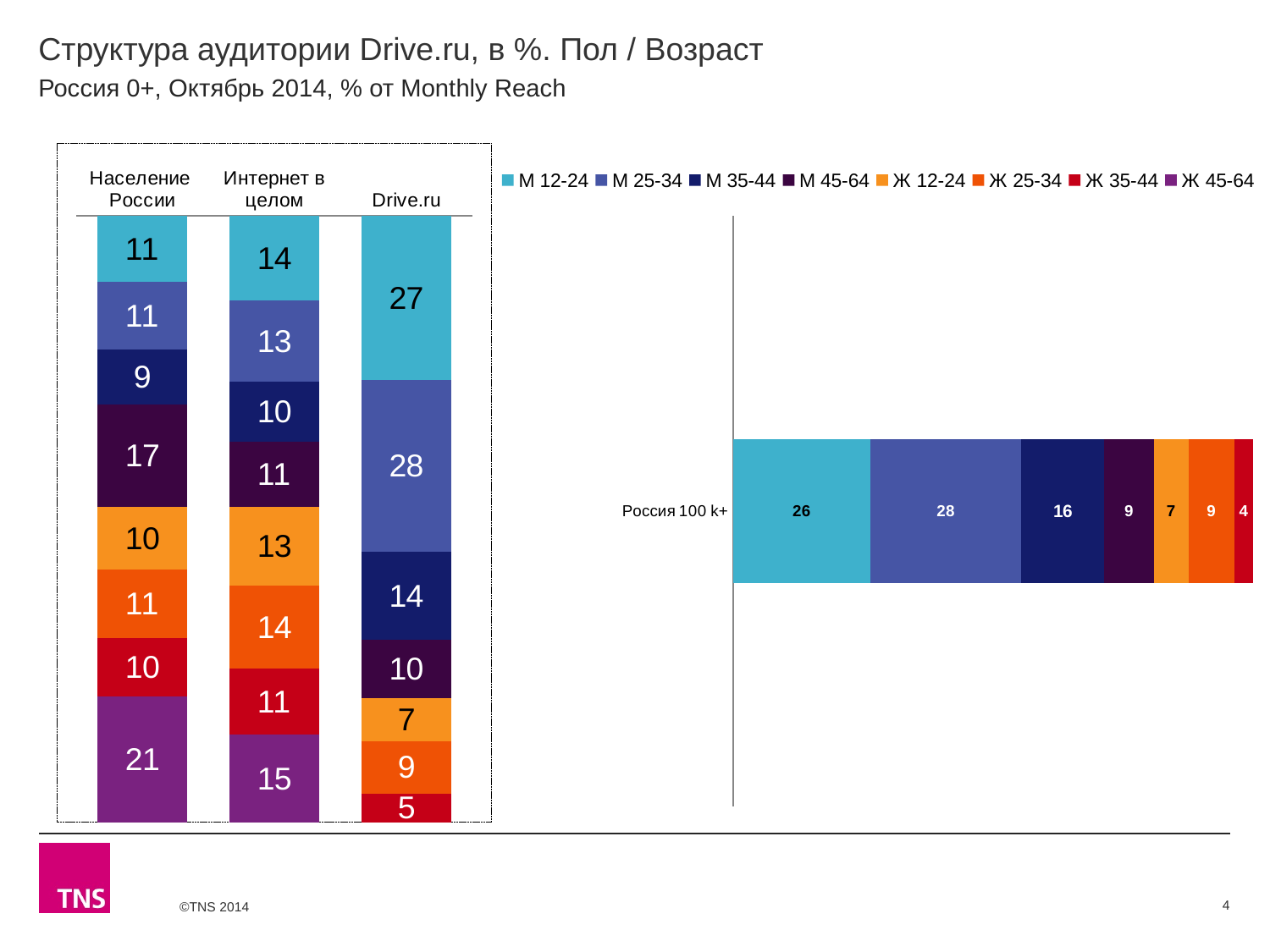
In the left stacked bar chart, what is the value for Ж 25-34 in the Интернет в целом bar? 14 How many series does the legend list? 8 In the left stacked bar chart, what is the difference between the М 12-24 values for Drive.ru and Население России? 16 In the Россия 100 k+ chart, what is the value for М 25-34? 28 In the left stacked bar chart, which is larger: М 45-64 for Население России or М 45-64 for Drive.ru? Население России In the left stacked bar chart, what is the value for Ж 45-64 in the Население России bar? 21 In the left stacked bar chart, what is the value for М 12-24 in the Drive.ru bar? 27 In the left stacked bar chart, which segment of the Drive.ru bar is the largest? М 25-34 How many bars (categories) does the left stacked bar chart show? 3 What type of chart is the Россия 100 k+ chart? Stacked bar chart In the left stacked bar chart, which segment of the Drive.ru bar is the smallest? Ж 35-44 In the Россия 100 k+ chart, what is the value for Ж 35-44? 4